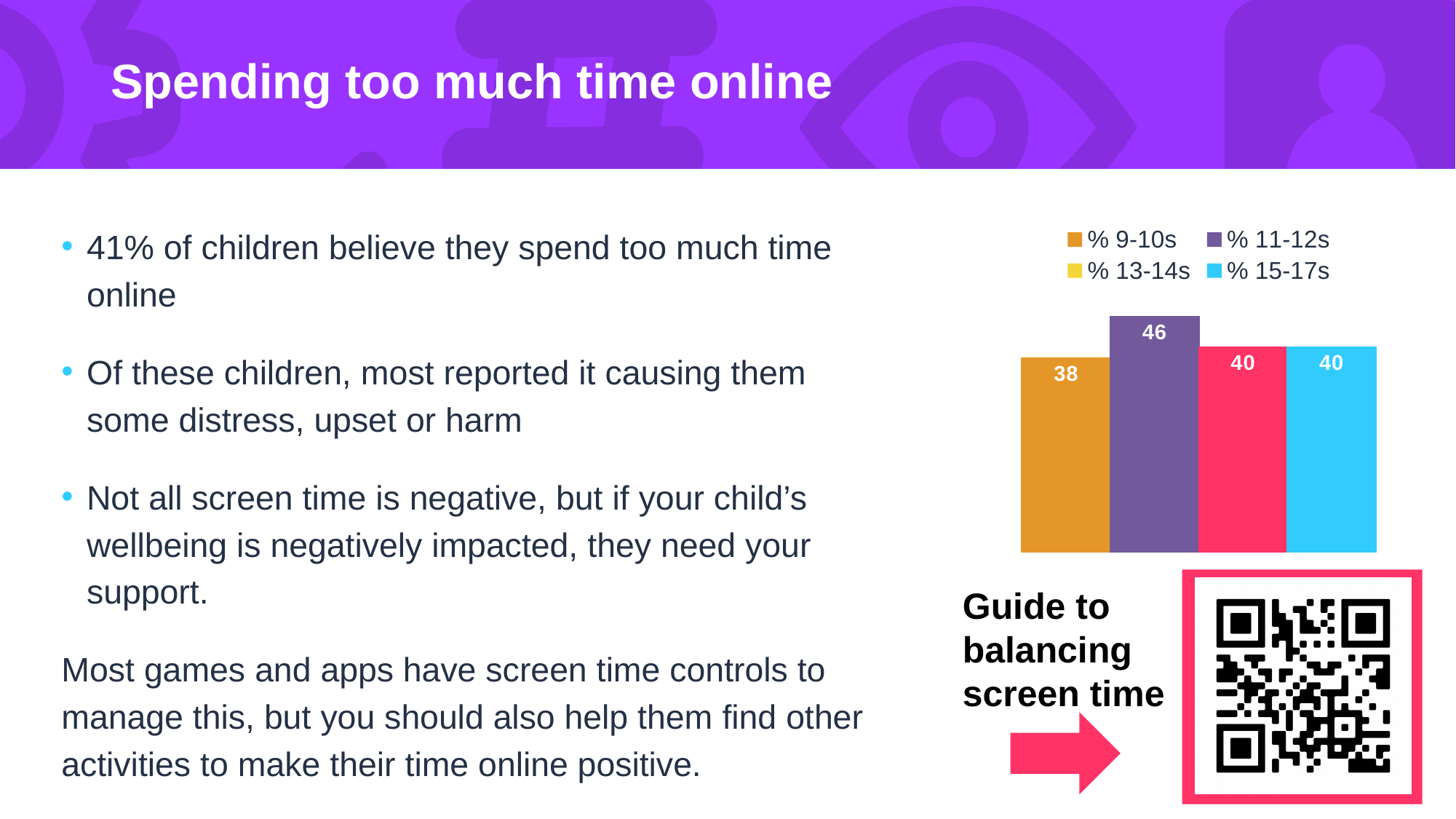
What is the difference between the values for % 13-14s and % 9-10s? 2 Which age group has the lowest value in the chart? % 9-10s What is the difference between the values for % 11-12s and % 9-10s? 8 What is the value for % 9-10s in the chart? 38 What kind of chart is shown on the slide? Bar chart How many bars are plotted in the chart? 4 Which is larger, the value for % 11-12s or the value for % 15-17s? % 11-12s What is the value for % 11-12s in the chart? 46 What is the value for % 15-17s in the chart? 40 How many series does the chart legend list? 4 What colour is the bar for % 9-10s? Orange Which age group has the highest value in the chart? % 11-12s